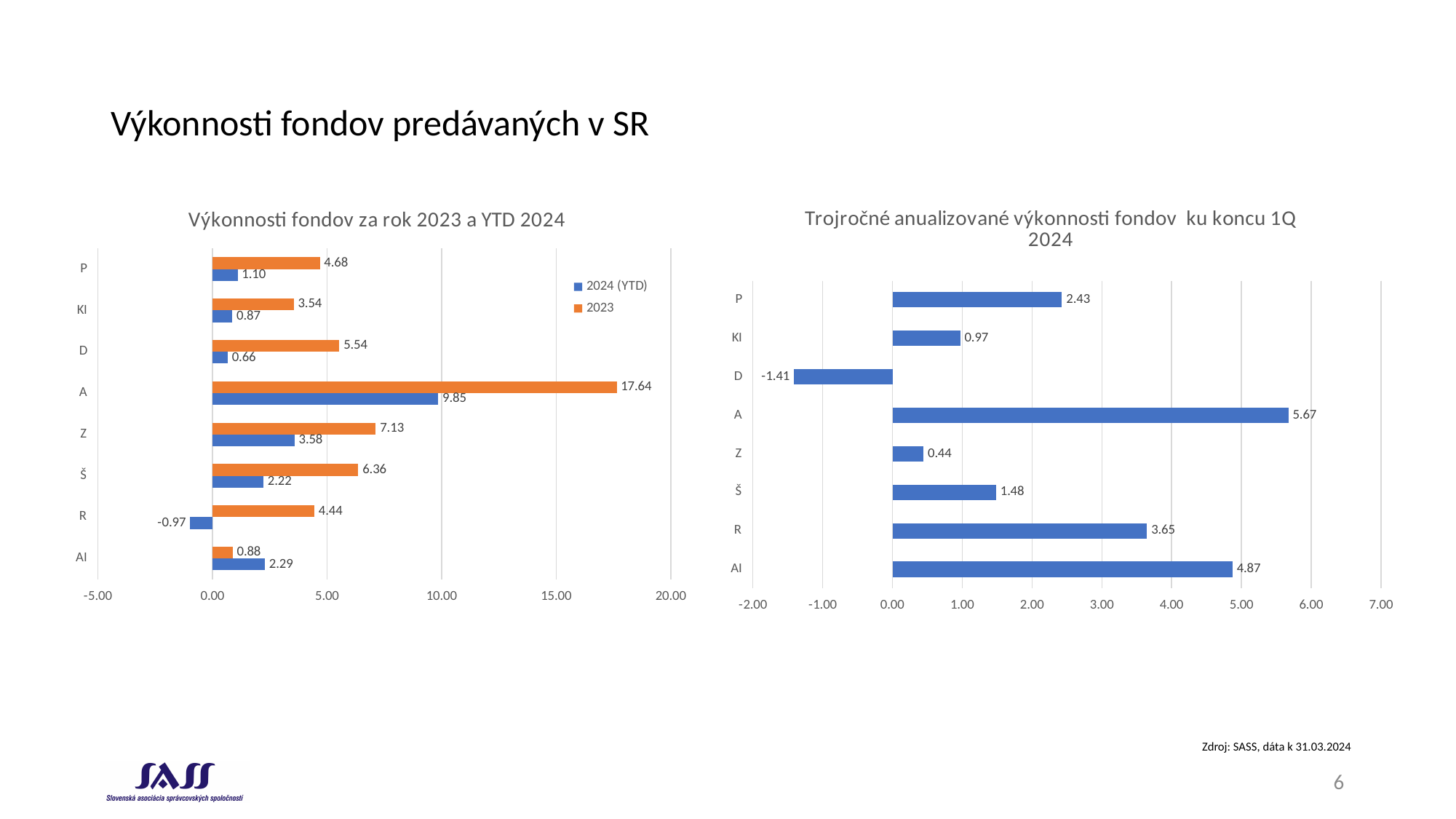
How many series does the legend of the left chart 'Výkonnosti fondov za rok 2023 a YTD 2024' list? 2 In the left chart 'Výkonnosti fondov za rok 2023 a YTD 2024', which category has the lowest 2023 value? AI In the left chart 'Výkonnosti fondov za rok 2023 a YTD 2024', what is the 2024 (YTD) value for R? -0.97 In the right chart 'Trojročné anualizované výkonnosti fondov ku koncu 1Q 2024', what is the value for D? -1.41 In the left chart 'Výkonnosti fondov za rok 2023 a YTD 2024', what is the difference between the 2023 and 2024 (YTD) values for Z? 3.55 In the left chart 'Výkonnosti fondov za rok 2023 a YTD 2024', which category has the highest 2024 (YTD) value? A In the left chart 'Výkonnosti fondov za rok 2023 a YTD 2024', what is the 2023 value for A? 17.64 In the left chart 'Výkonnosti fondov za rok 2023 a YTD 2024', which is larger for AI: the 2023 value or the 2024 (YTD) value? 2024 (YTD) In the right chart 'Trojročné anualizované výkonnosti fondov ku koncu 1Q 2024', which category has the highest value? A What kind of chart is the right chart 'Trojročné anualizované výkonnosti fondov ku koncu 1Q 2024'? Bar chart How many categories are shown in the right chart 'Trojročné anualizované výkonnosti fondov ku koncu 1Q 2024'? 8 In the right chart 'Trojročné anualizované výkonnosti fondov ku koncu 1Q 2024', what is the difference between the values for AI and R? 1.22